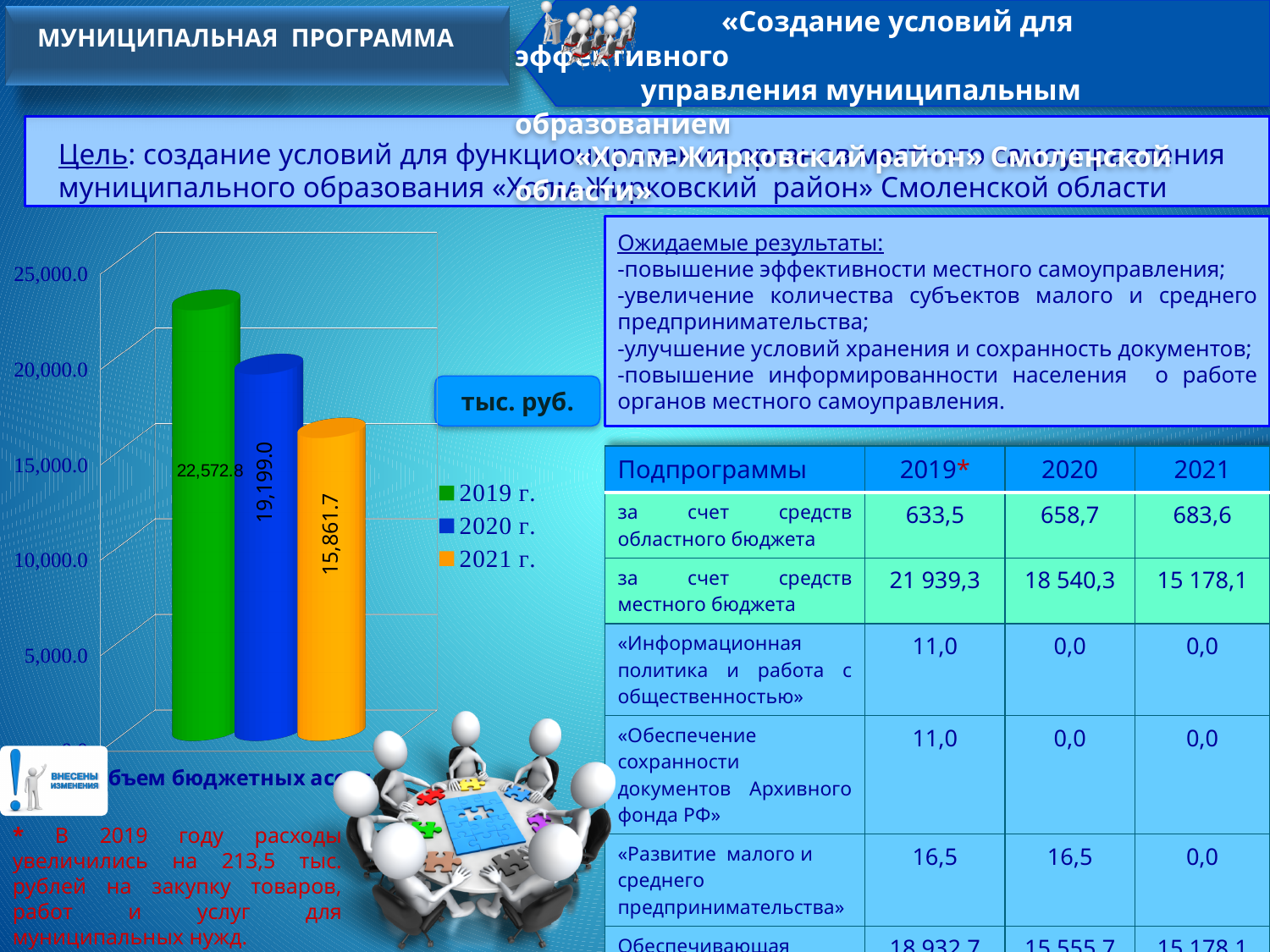
What is the difference between the values for 2019 г. and 2020 г.? 3,373.8 How many bars are plotted on the chart? 3 What is the value for 2021 г. on the chart? 15,861.7 What is the value for 2019 г. on the chart? 22,572.8 Is the value for 2020 г. greater or less than 20,000.0? less Which is larger, the value for 2020 г. or the value for 2021 г.? 2020 г. Which year has the highest value on the chart? 2019 г. What kind of chart is shown on the slide? bar chart What is the value for 2020 г. on the chart? 19,199.0 What is the difference between the values for 2019 г. and 2021 г.? 6,711.1 Which year has the lowest value on the chart? 2021 г. How many entries does the chart legend list? 3